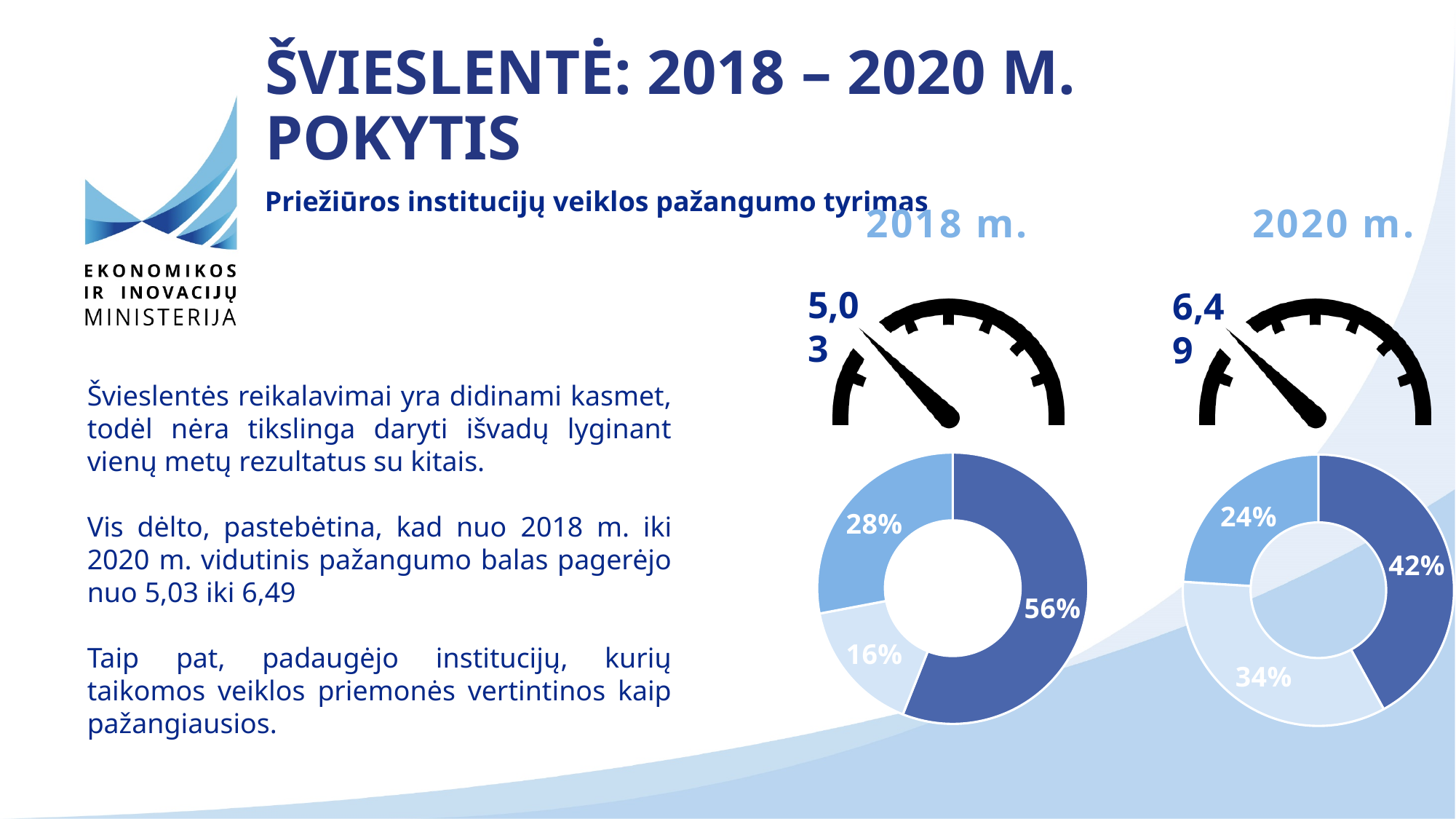
Which chart has the larger dark blue slice, the 2018 m. chart or the 2020 m. chart? 2018 m. What kind of chart is shown below the 2018 m. heading? doughnut (pie) chart What value is shown on the 2020 m. gauge? 6,49 In the 2018 m. doughnut chart, what is the smallest slice's value? 16% In the 2018 m. doughnut chart, what is the difference between the largest and smallest slices? 40 percentage points In the 2020 m. doughnut chart, how many slices are there? 3 In the 2020 m. doughnut chart, what is the value of the dark blue slice? 42% In the 2020 m. doughnut chart, what is the smallest slice's value? 24% In the 2018 m. doughnut chart, how many slices are there? 3 In the 2018 m. doughnut chart, what is the largest slice's value? 56% What value is shown on the 2018 m. gauge? 5,03 In the 2020 m. doughnut chart, what is the largest slice's value? 42%